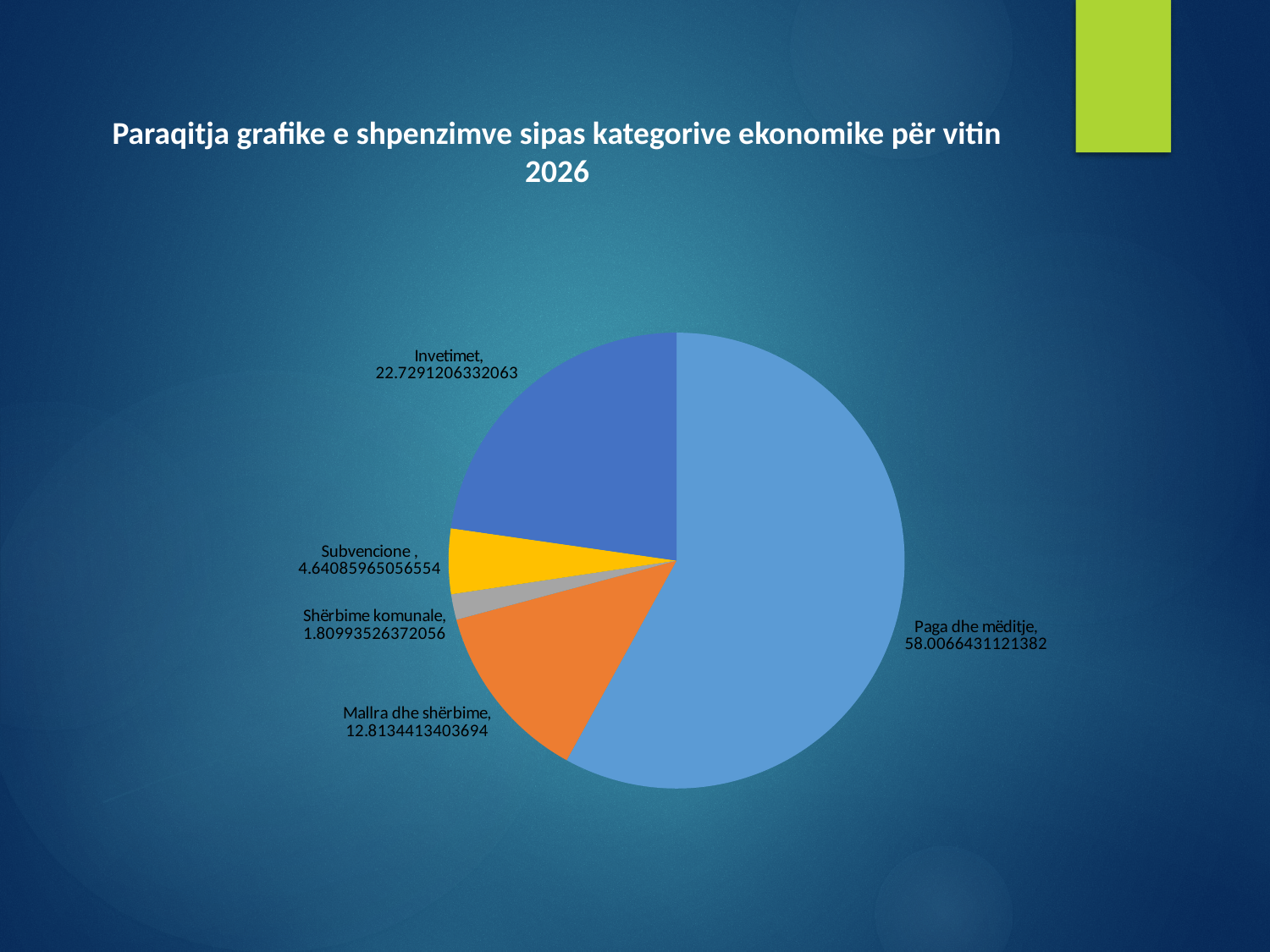
What is the value for Shërbime komunale in the pie chart? 1.80993526372056 What is the value for Mallra dhe shërbime in the pie chart? 12.8134413403694 Which is larger, Invetimet or Mallra dhe shërbime? Invetimet Which category has the largest slice in the pie chart? Paga dhe mëditje What is the value for Paga dhe mëditje in the pie chart? 58.0066431121382 Which category has the smallest slice in the pie chart? Shërbime komunale What is the value for Subvencione in the pie chart? 4.64085965056554 What kind of chart is shown on the slide? Pie chart What is the difference between the values for Paga dhe mëditje and Invetimet? 35.2775224789319 What is the value for Invetimet in the pie chart? 22.7291206332063 What is the title of the slide? Paraqitja grafike e shpenzimve sipas kategorive ekonomike për vitin 2026 How many categories are shown in the pie chart? 5